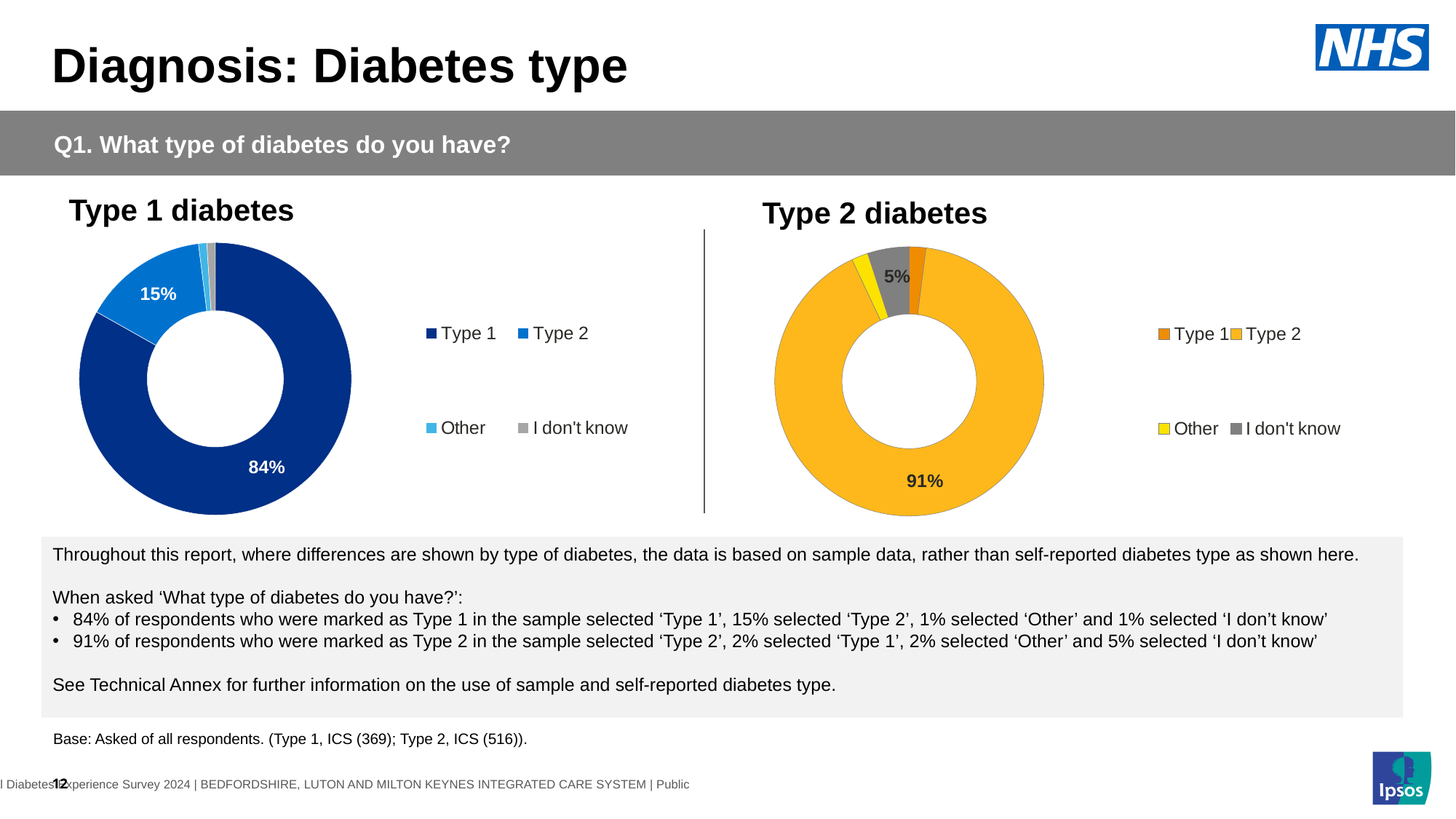
In the Type 2 diabetes chart, what colour represents the 'I don't know' category? Grey How many categories does the legend of the Type 2 diabetes chart list? 4 In the Type 1 diabetes chart, which category has the largest share? Type 1 In the Type 1 diabetes chart, what percentage of respondents selected 'Type 2'? 15% In the Type 2 diabetes chart, which category has the largest share? Type 2 In the Type 2 diabetes chart, what percentage of respondents selected 'Type 2'? 91% In the Type 2 diabetes chart, which is larger: the 'Type 2' share or the 'I don't know' share? Type 2 In the Type 1 diabetes chart, what percentage of respondents selected 'Type 1'? 84% In the Type 1 diabetes chart, what colour represents the 'Other' category? Light blue What kind of chart is used for the Type 1 diabetes data? Doughnut (pie) chart In the Type 1 diabetes chart, what is the difference in percentage points between the 'Type 1' and 'Type 2' shares? 69 percentage points In the Type 2 diabetes chart, what percentage of respondents selected 'I don't know'? 5%